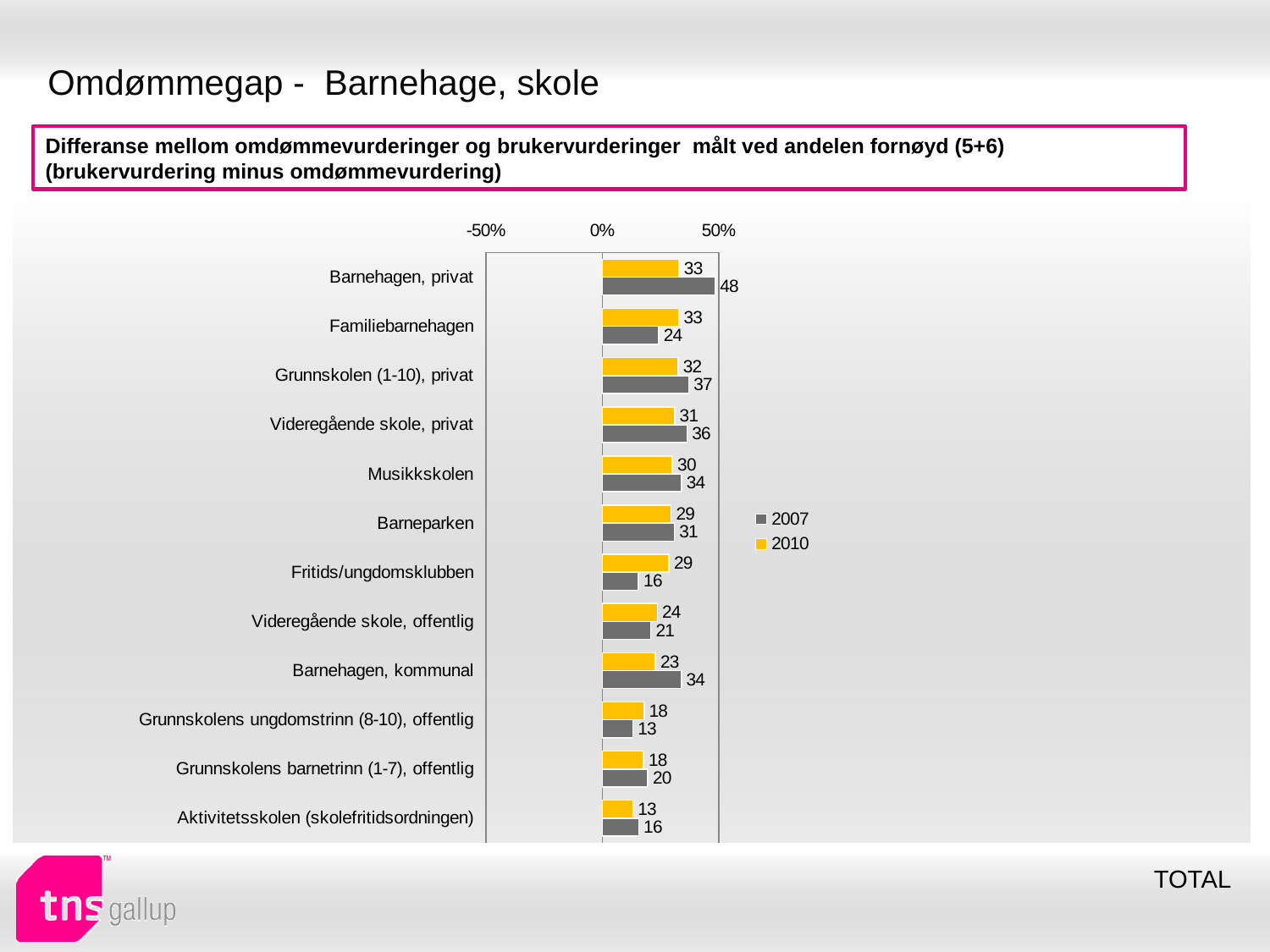
What kind of chart is shown on the slide? Bar chart How many categories are shown on the chart? 12 What is the difference between the 2007 and 2010 values for Barnehagen, privat? 15 What is the 2010 value for Fritids/ungdomsklubben? 29 What is the 2007 value for Barnehagen, kommunal? 34 Which category has the lowest 2010 value? Aktivitetsskolen (skolefritidsordningen) What is the 2007 value for Barnehagen, privat? 48 For Familiebarnehagen, which is larger: the 2007 value or the 2010 value? 2010 Which category has the highest 2007 value? Barnehagen, privat Which colour represents the 2010 series in the chart? Yellow How many series does the legend list? 2 What is the difference between the 2010 and 2007 values for Fritids/ungdomsklubben? 13